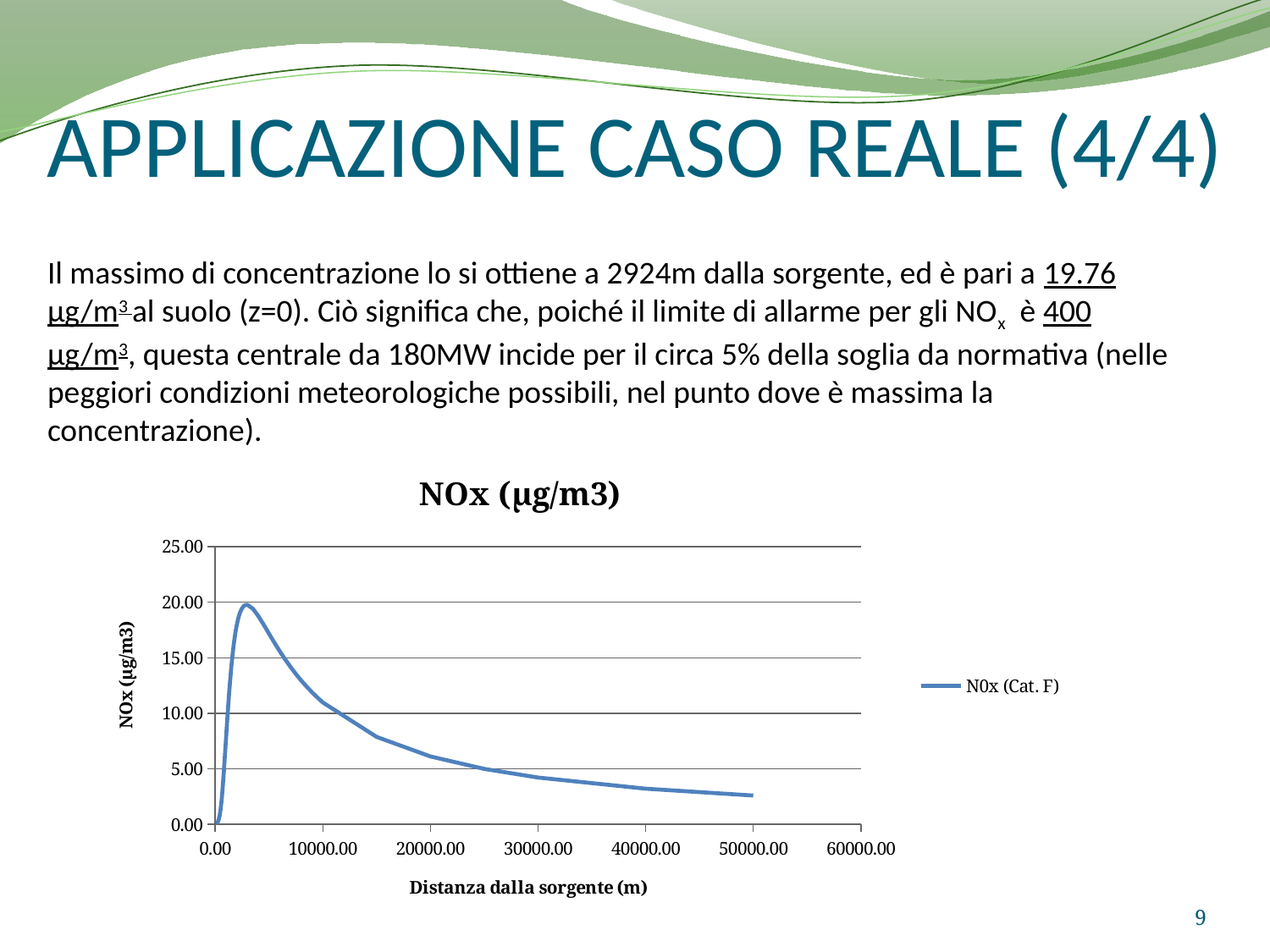
How many series does the chart legend list? 1 Is the value of the N0x (Cat. F) line at 20000.00 m greater or less than 10.00? less Is the value of the N0x (Cat. F) line at 30000.00 m greater or less than 5.00? less After its peak, does the N0x (Cat. F) line rise or fall as the distance from the source increases? fall Is the value of the N0x (Cat. F) line at 50000.00 m greater or less than 5.00? less Which is larger: the N0x (Cat. F) value at 10000.00 m or at 30000.00 m? 10000.00 m Does the N0x (Cat. F) line reach its maximum before or after 10000.00 m on the x axis? before What is the legend entry for the plotted series? N0x (Cat. F) What kind of chart is shown on the slide? line chart What is the title of the chart? NOx (μg/m3)